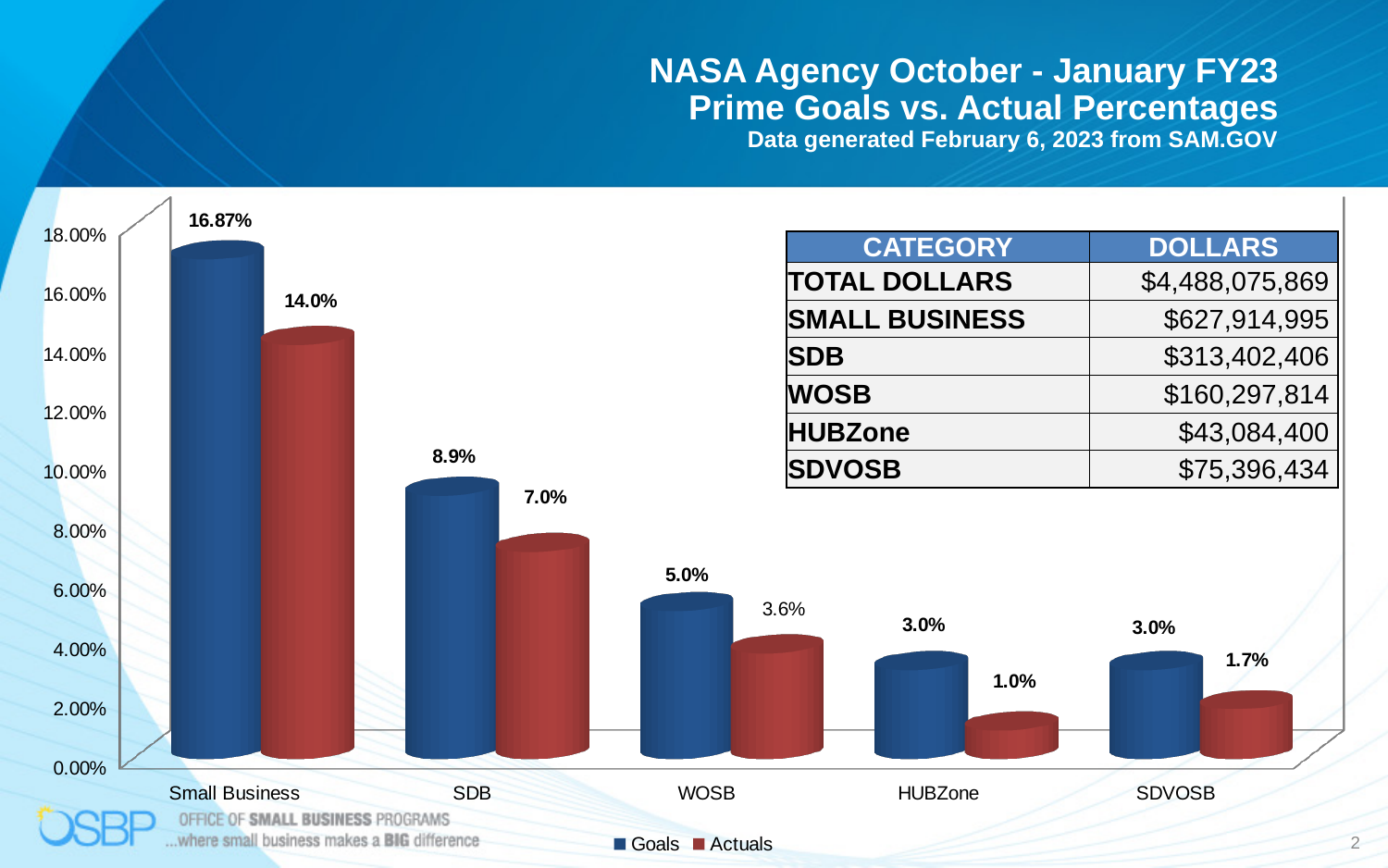
What is the Goals value for SDB? 8.9% How many categories are shown on the x axis? 5 What is the Actuals value for HUBZone? 1.0% What is the Goals value for Small Business? 16.87% What kind of chart is shown on the slide? Bar chart How many series does the legend list? 2 Which category has the lowest Actuals value? HUBZone Which is larger, the Actuals value for SDVOSB or the Actuals value for HUBZone? SDVOSB What is the difference between the Goals and Actuals values for SDB? 1.9% What is the Actuals value for WOSB? 3.6% Which series is shown in red in the legend? Actuals Which category has the highest Actuals value? Small Business